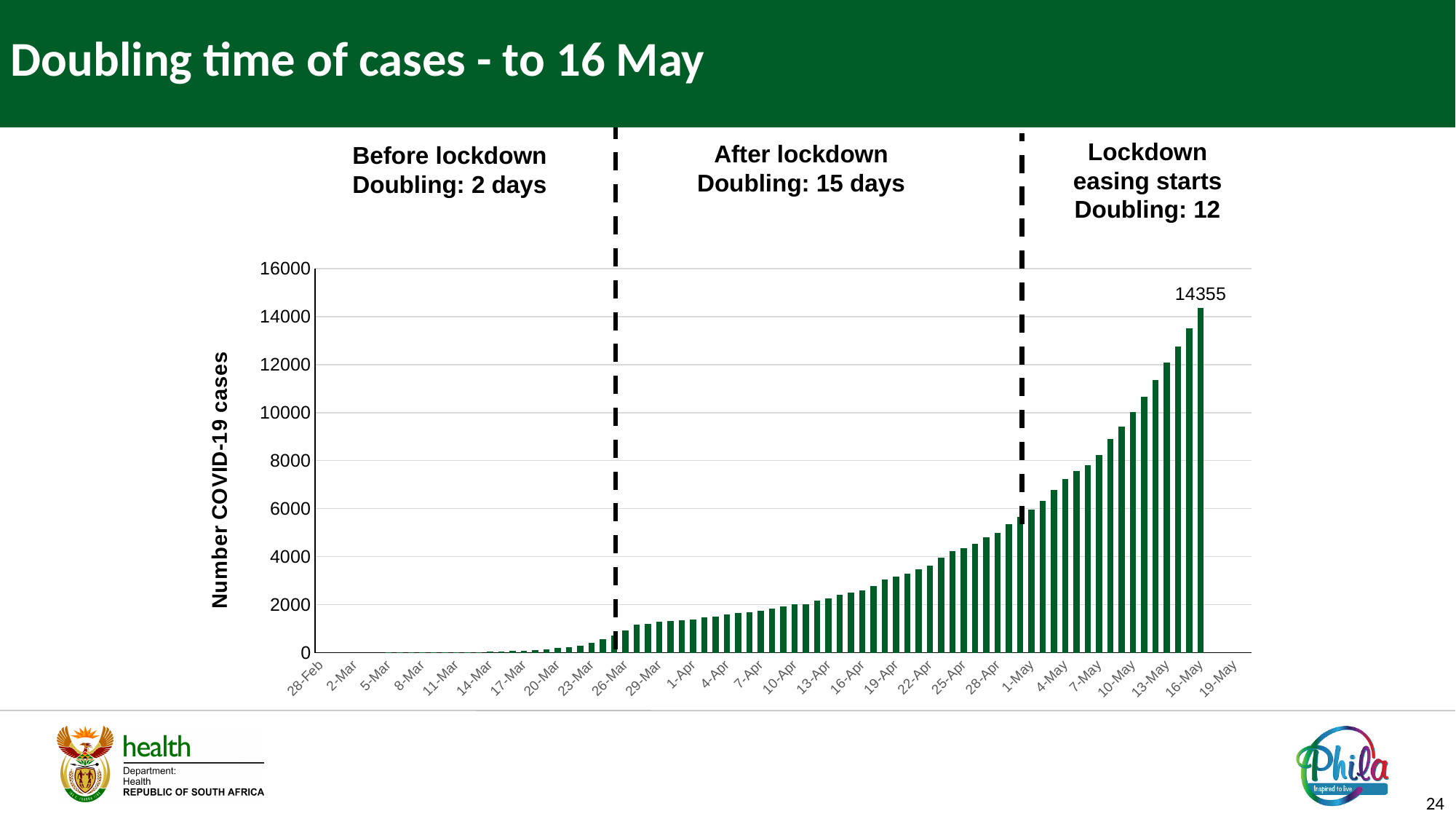
Is the number of cases on 1-May greater or less than 4000? greater Is the number of cases on 1-Apr greater or less than 2000? less What is the label on the vertical axis of the chart? Number COVID-19 cases Which date has the highest number of COVID-19 cases? 16-May Is the number of cases on 7-May greater or less than 6000? greater Which date has more COVID-19 cases, 28-Feb or 16-May? 16-May What kind of chart is used to show the number of COVID-19 cases? bar chart What is the number of COVID-19 cases shown for 16-May? 14355 According to the annotation on the chart, what was the doubling time after lockdown? 15 days Do the number of COVID-19 cases rise or fall from 28-Feb to 16-May? rise